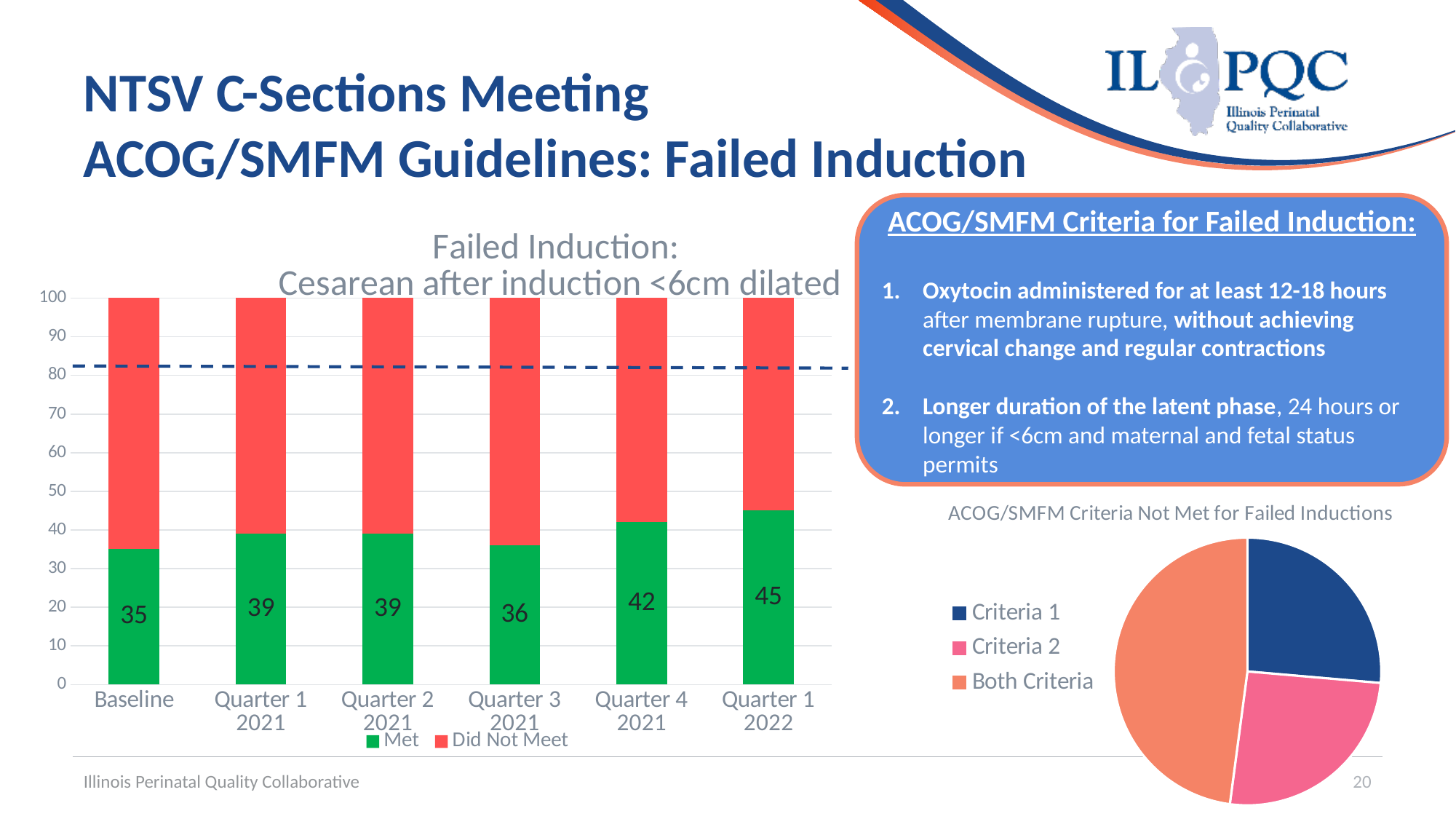
What kind of chart is the Failed Induction chart on the left of the slide? Stacked bar chart In the Failed Induction bar chart, which has the larger Met value, Quarter 4 2021 or Quarter 3 2021? Quarter 4 2021 In the ACOG/SMFM Criteria Not Met for Failed Inductions pie chart, which slice is the largest? Both Criteria In the Failed Induction bar chart, which period has the lowest Met value? Baseline In the Failed Induction bar chart, how many periods are shown on the x axis? 6 In the Failed Induction bar chart, what is the Met value for Baseline? 35 In the Failed Induction bar chart, what is the total height of the stacked bar for Baseline? 100 In the ACOG/SMFM Criteria Not Met for Failed Inductions pie chart, how many slices are there? 3 In the Failed Induction bar chart, what is the difference between the Met value for Quarter 1 2022 and the Met value for Baseline? 10 In the Failed Induction bar chart, what is the Met value for Quarter 1 2022? 45 In the Failed Induction bar chart, how many series does the legend list? 2 In the Failed Induction bar chart, which period has the highest Met value? Quarter 1 2022